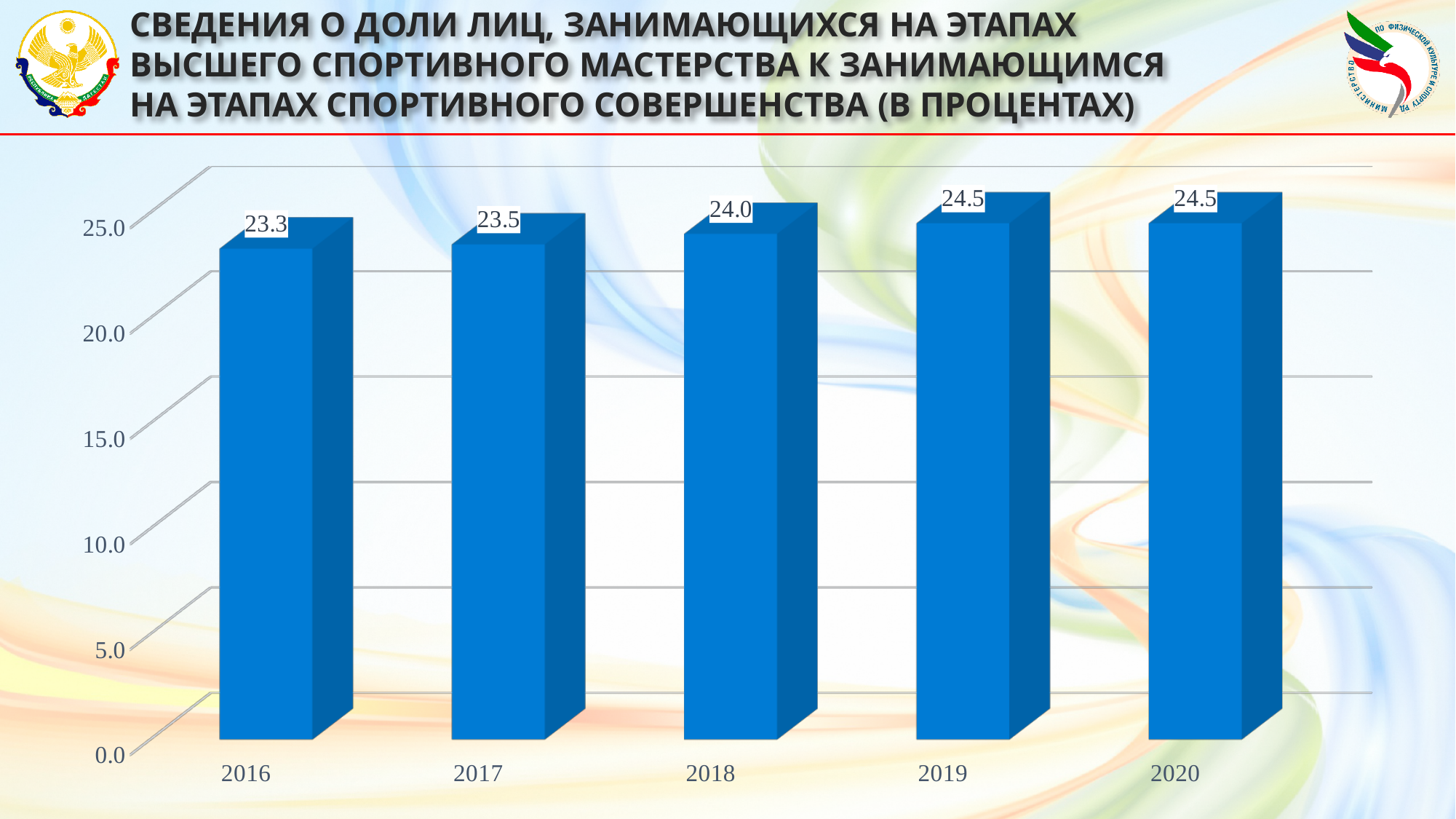
What is the value for 2020? 24.5 What colour are the bars in the chart? blue Which year has the lowest value? 2016 What is the difference between the values for 2018 and 2017? 0.5 Do the values rise or fall from 2016 to 2019? rise What is the difference between the values for 2019 and 2016? 1.2 Is the value for 2016 greater or less than 20.0? greater What is the value for 2016? 23.3 What kind of chart is shown on the slide? bar chart How many years are shown on the x axis? 5 What is the value for 2018? 24.0 Which is larger, the value for 2017 or the value for 2018? 2018